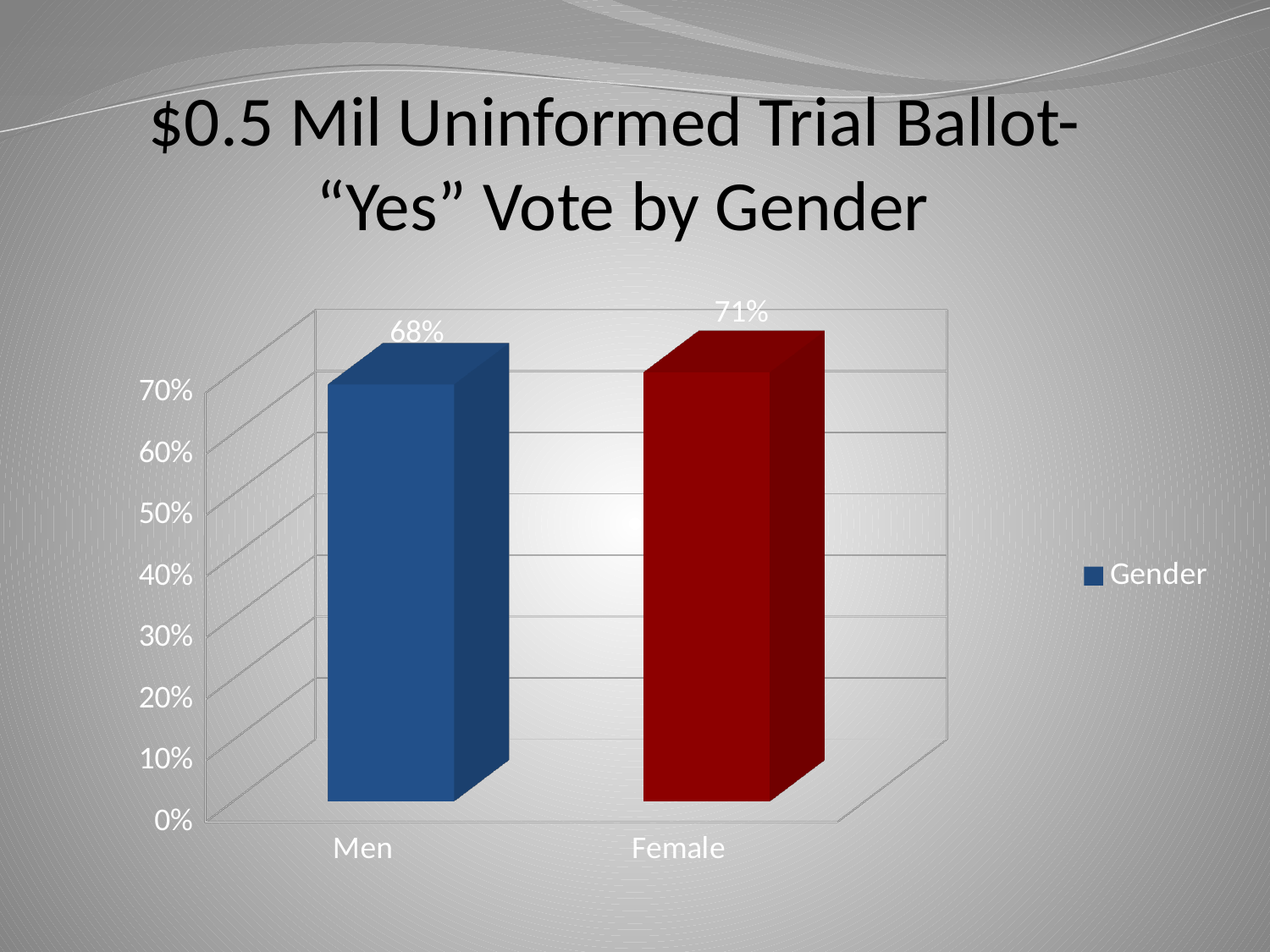
What is the "Yes" vote percentage for Men? 68% Which category has the higher "Yes" vote percentage? Female Is the "Yes" vote for Men greater or less than 60%? greater Which category has the lower "Yes" vote percentage? Men How many series does the legend list? 1 What is the name of the series listed in the legend? Gender What kind of chart is shown on the slide? Bar chart What is the "Yes" vote percentage for Female? 71% Is the "Yes" vote for Female greater or less than 70%? greater What colour is the bar for Female? Red What is the difference between the Female and Men "Yes" vote percentages? 3% How many categories are shown on the x axis? 2